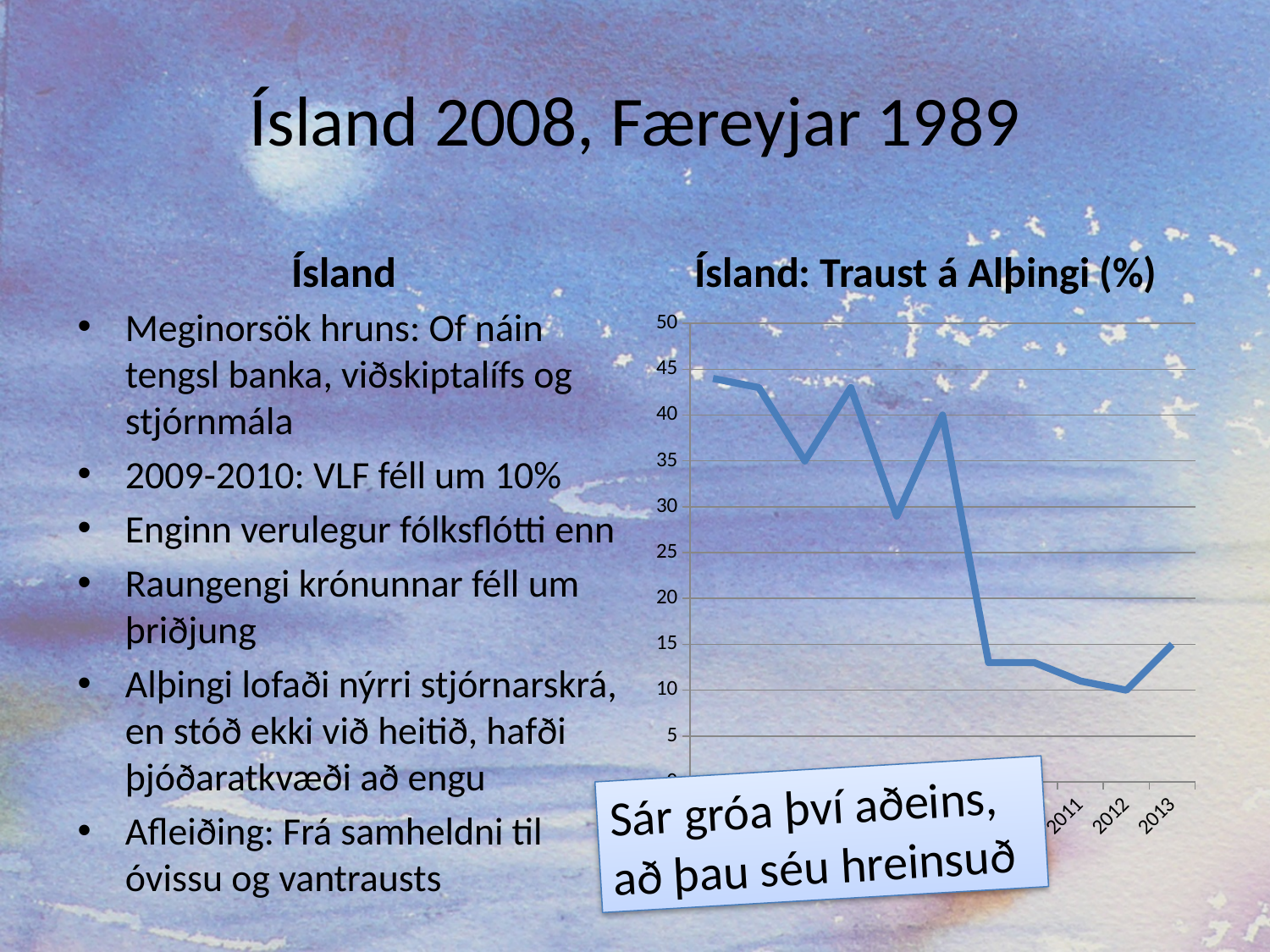
What kind of chart is shown on the slide? line chart Do the values generally rise or fall from the start of the line to 2013? fall Is the value for 2012 greater or less than 20? less Which year has the larger value, 2012 or 2013? 2013 What is the title of the chart on the slide? Ísland: Traust á Alþingi (%) Is the value for 2013 greater or less than 20? less Is the value for 2011 greater or less than 20? less What is the highest value shown on the vertical axis? 50 How many lines are plotted on the chart? 1